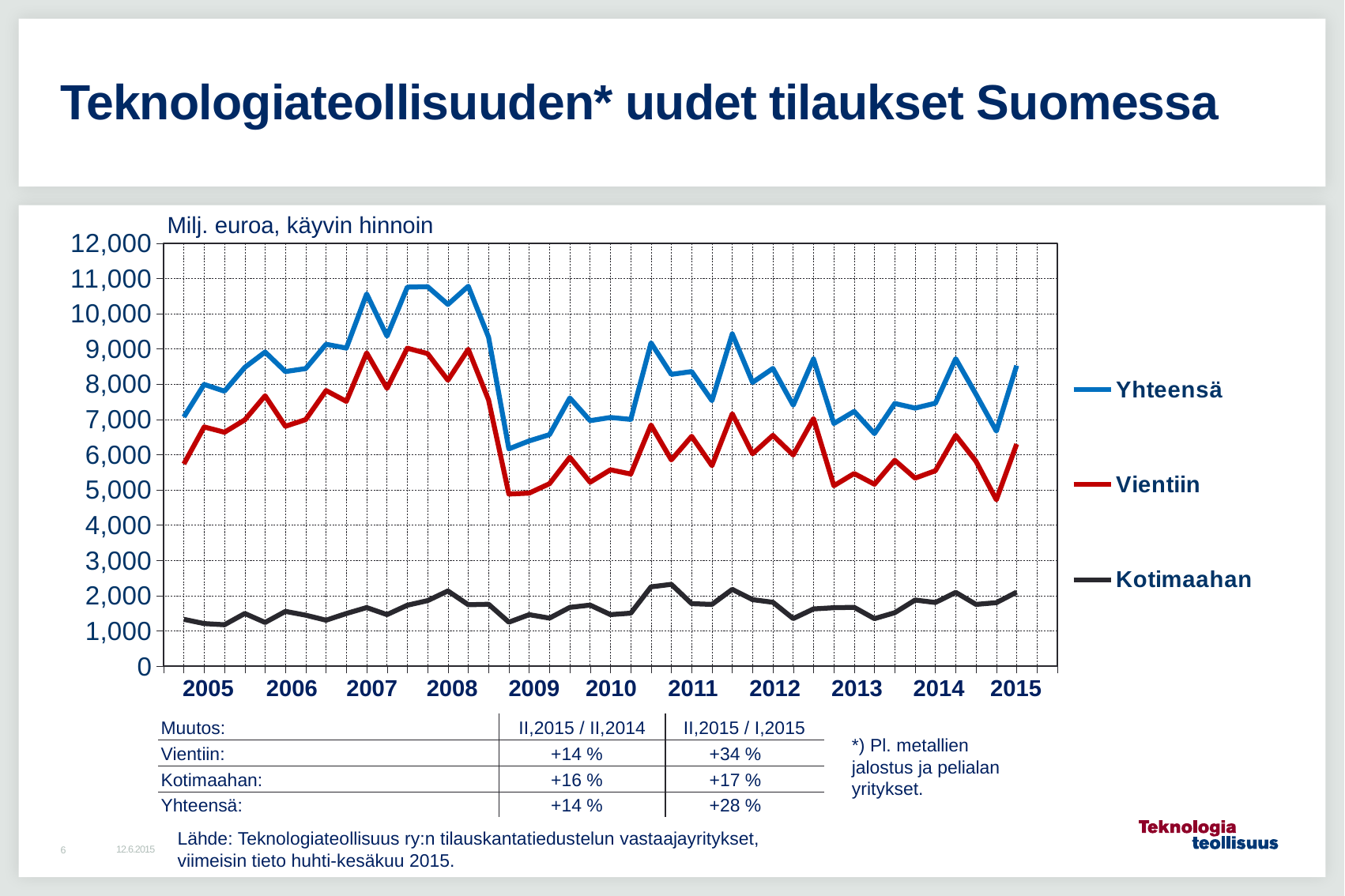
Is the value for Yhteensä at the start of 2008 greater or less than 10,000? greater Is the value for Kotimaahan in 2015 greater or less than 3,000? less Which series has the lowest values throughout the chart? Kotimaahan What kind of chart is shown on the slide? line chart What unit label is shown above the y axis? Milj. euroa, käyvin hinnoin How many year labels are shown on the x axis? 11 Does the Yhteensä line rise or fall between 2008 and 2009? fall Which series is plotted with the red line? Vientiin Which series has the highest values throughout the chart? Yhteensä Is the value for Vientiin at the start of 2009 greater or less than 6,000? less How many series does the legend list? 3 Which is larger in 2015, the value for Vientiin or the value for Kotimaahan? Vientiin